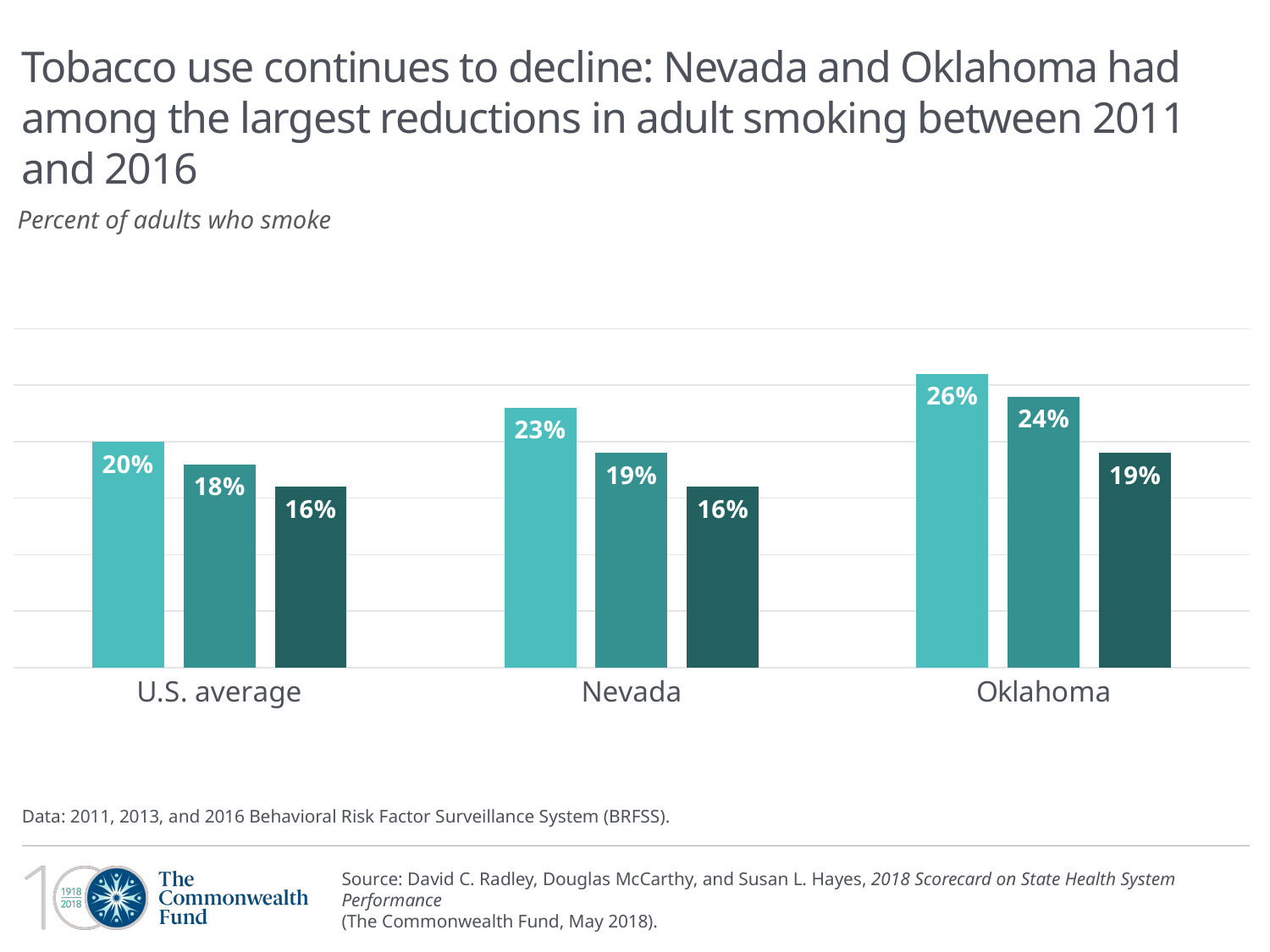
Which category has the lowest value among the middle bars? U.S. average Which is larger: the middle bar for Oklahoma or the leftmost bar for Nevada? the middle bar for Oklahoma Which category has the highest value among the leftmost (lightest) bars? Oklahoma Within each category, do the values rise or fall from the leftmost bar to the rightmost bar? fall What is the value of the leftmost (lightest) bar for Oklahoma? 26% What is the value of the middle bar for Nevada? 19% How many categories are shown along the x axis of the chart? 3 What is the value of the middle bar for U.S. average? 18% What is the difference between the leftmost and rightmost bars for Nevada? 7% What kind of chart is shown on the slide? bar chart What is the value of the rightmost (darkest) bar for U.S. average? 16% What is the difference between the leftmost bar for Oklahoma and the leftmost bar for U.S. average? 6%